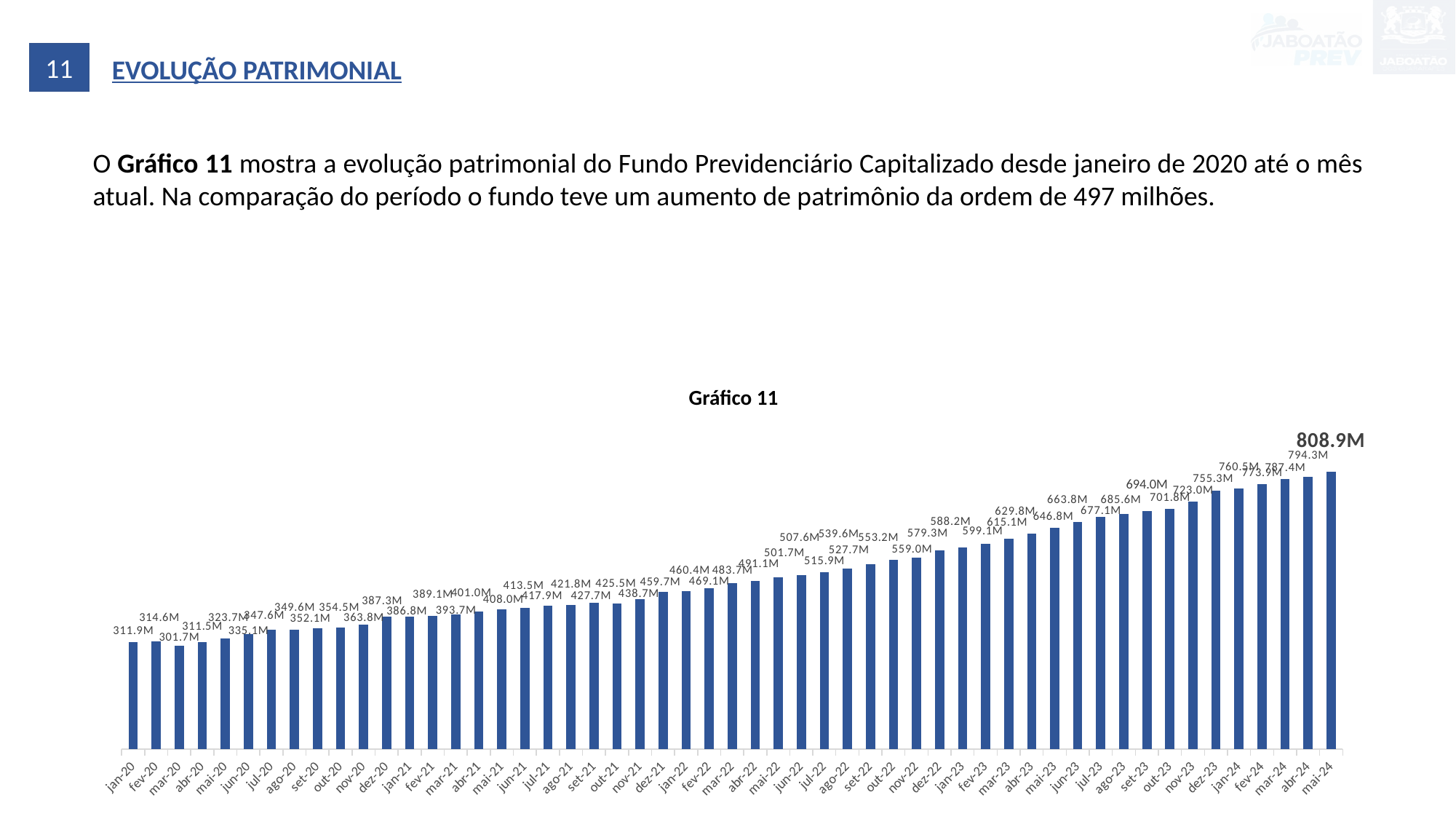
Which month has the highest value in Gráfico 11? mai-24 Which is larger in Gráfico 11, the value for dez-23 or the value for dez-22? dez-23 What is the value for mar-20 in Gráfico 11? 301.7M Which month has the lowest value in Gráfico 11? mar-20 What is the difference between the values for mai-24 and abr-24 in Gráfico 11? 14.6M How many bars are plotted in Gráfico 11? 53 Do the values in Gráfico 11 generally rise or fall from jan-20 to mai-24? Rise What is the value for mai-24 in Gráfico 11? 808.9M What is the value for jan-20 in Gráfico 11? 311.9M What is the title of the chart on the slide? Gráfico 11 What is the difference between the values for mai-24 and jan-20 in Gráfico 11? 497.0M What kind of chart is Gráfico 11? Bar chart